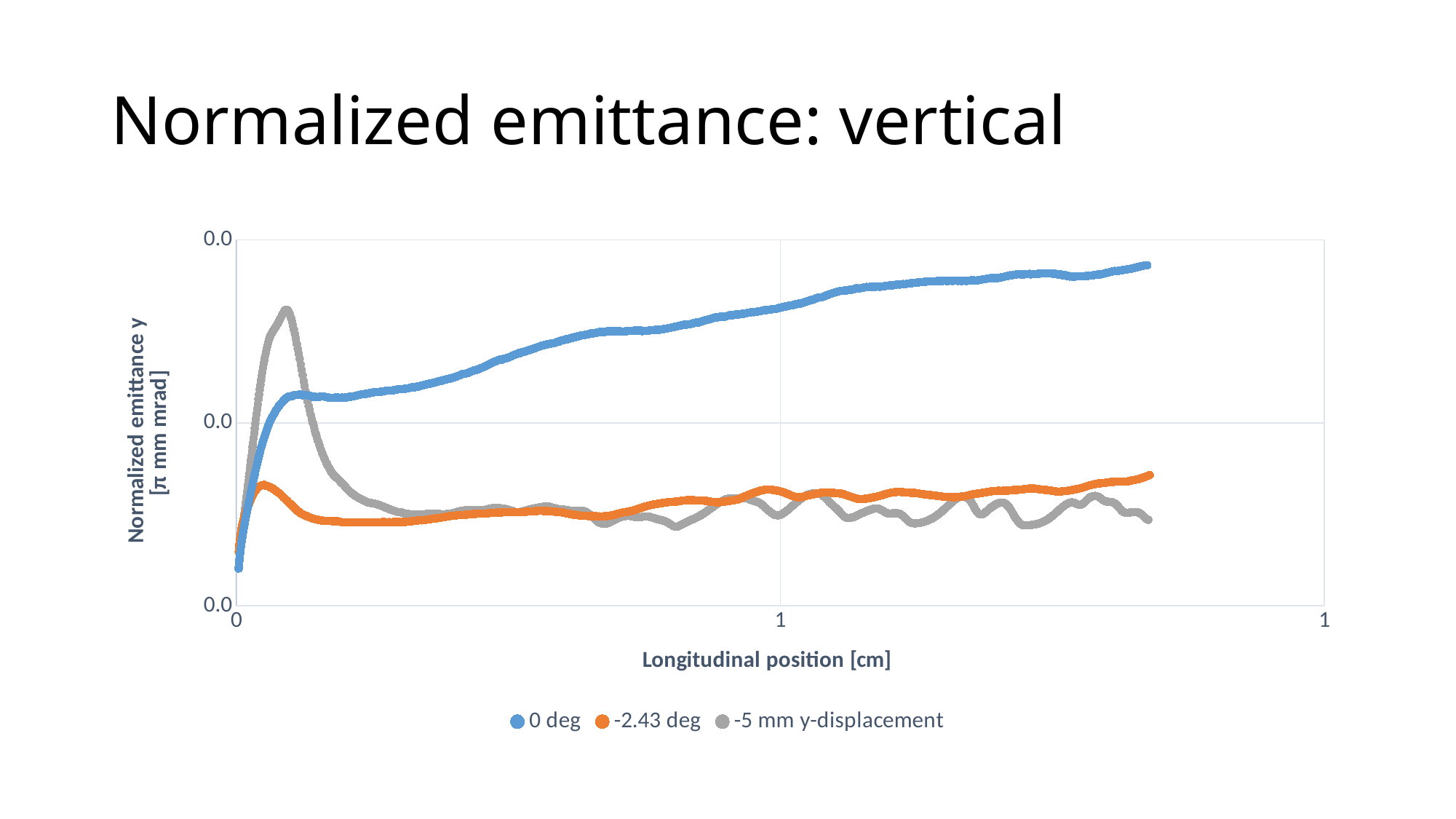
Which series has the highest value at the right end of the chart? 0 deg Does the 0 deg series generally rise or fall along the x axis? rise What is the title of the x axis? Longitudinal position [cm] What kind of chart is shown on the slide? line chart Over the right half of the chart, which series is higher: 0 deg or -5 mm y-displacement? 0 deg After its early peak, does the -5 mm y-displacement series rise or fall? fall At the x-axis tick labelled 1 in the middle of the chart, which is higher: 0 deg or -2.43 deg? 0 deg Which series has the lowest value at the right end of the chart? -5 mm y-displacement At the right end of the chart, which is higher: -2.43 deg or -5 mm y-displacement? -2.43 deg How many series does the legend list? 3 What are the three series named in the legend? 0 deg, -2.43 deg, -5 mm y-displacement Which series reaches the highest peak near the start of the x axis? -5 mm y-displacement